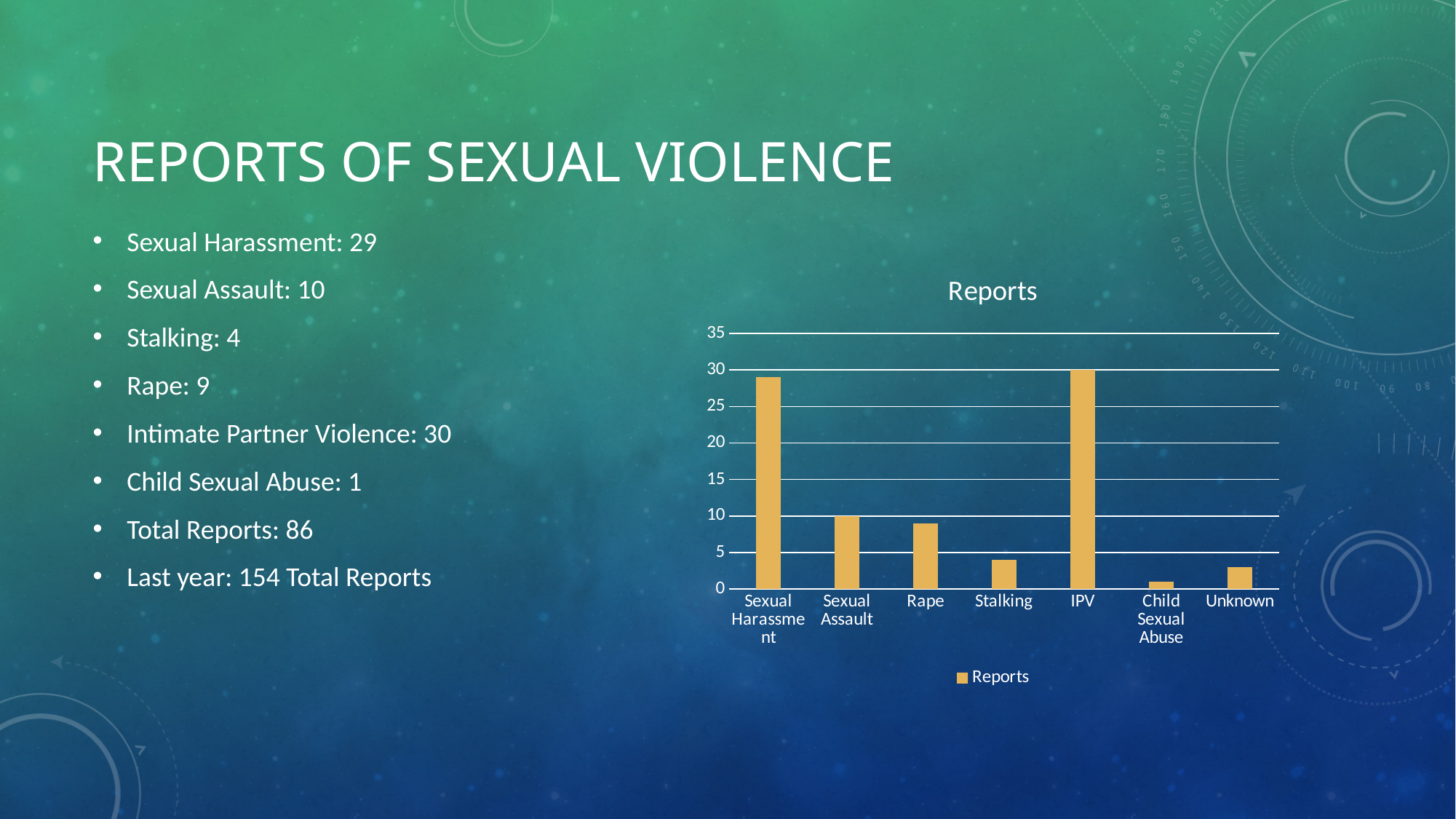
Which is larger, the value for Sexual Harassment or the value for Sexual Assault? Sexual Harassment Which category has the highest bar in the chart? IPV What is the title of the chart? Reports What type of chart is shown on the slide? bar chart How many categories are shown on the x axis of the chart? 7 What is the value for IPV in the chart? 30 What is the difference between the values for IPV and Sexual Assault? 20 How many series does the chart legend list? 1 Is the value for Stalking greater or less than 5? less What is the value for Sexual Assault in the chart? 10 Which category has the lowest bar in the chart? Child Sexual Abuse Is the value for Sexual Harassment greater or less than 25? greater